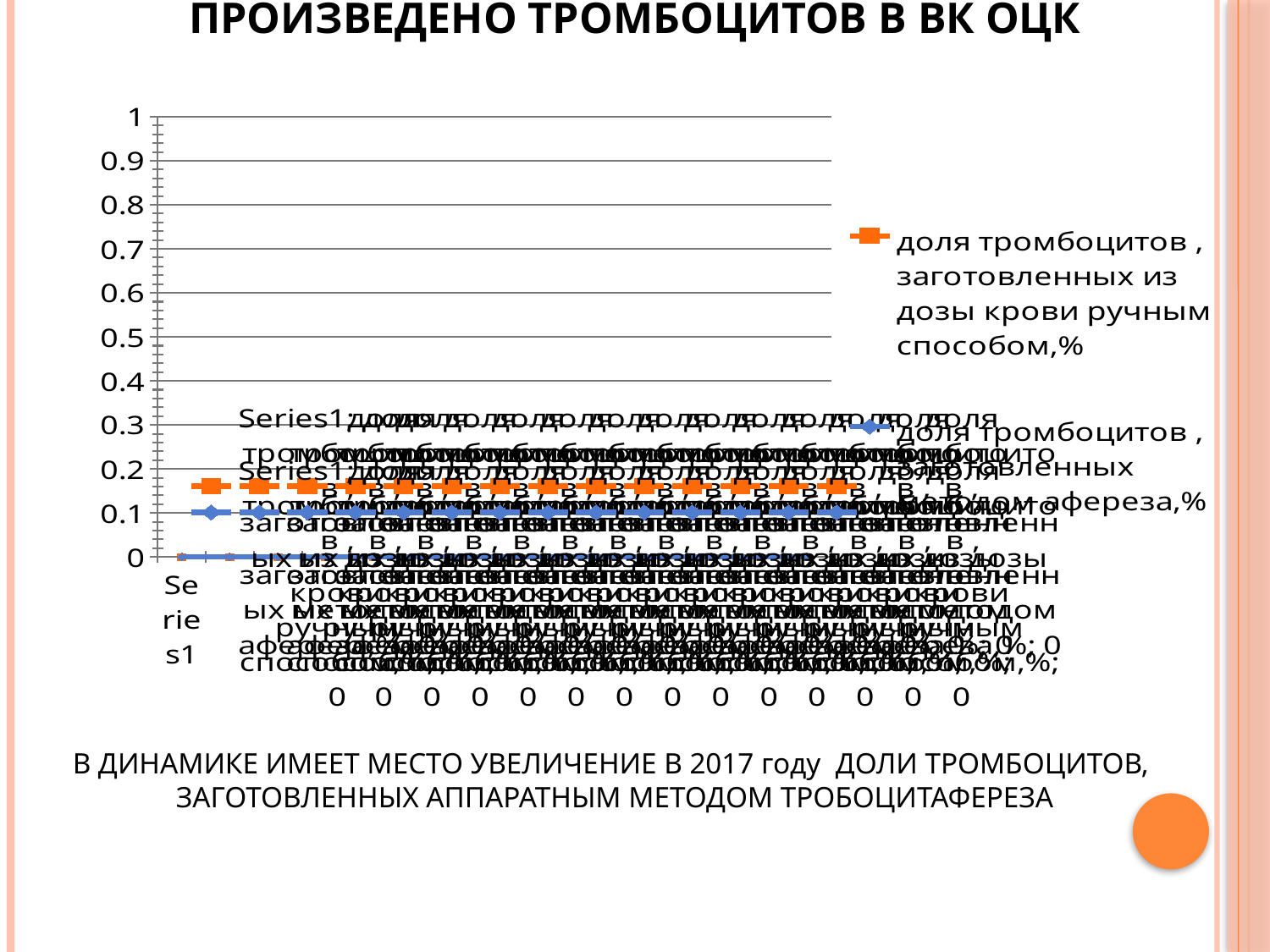
How many series does the chart legend list? 2 Are the values of the orange series greater or less than 0.3? less What is the title of the chart on the slide? ПРОИЗВЕДЕНО ТРОМБОЦИТОВ В ВК ОЦК What kind of chart is shown on the slide? line chart Which colour is used for the series 'доля тромбоцитов, заготовленных из дозы крови ручным способом,%'? orange Which series is plotted higher on the chart: the one for platelets prepared by hand ('ручным способом') or the one for platelets prepared by apheresis ('методом афереза')? ручным способом Are the values of the series 'доля тромбоцитов, заготовленных из дозы крови ручным способом,%' greater or less than 0.5? less Are the values of the series 'доля тромбоцитов, заготовленных методом афереза,%' greater or less than 0.5? less What is the highest value shown on the vertical axis of the chart? 1